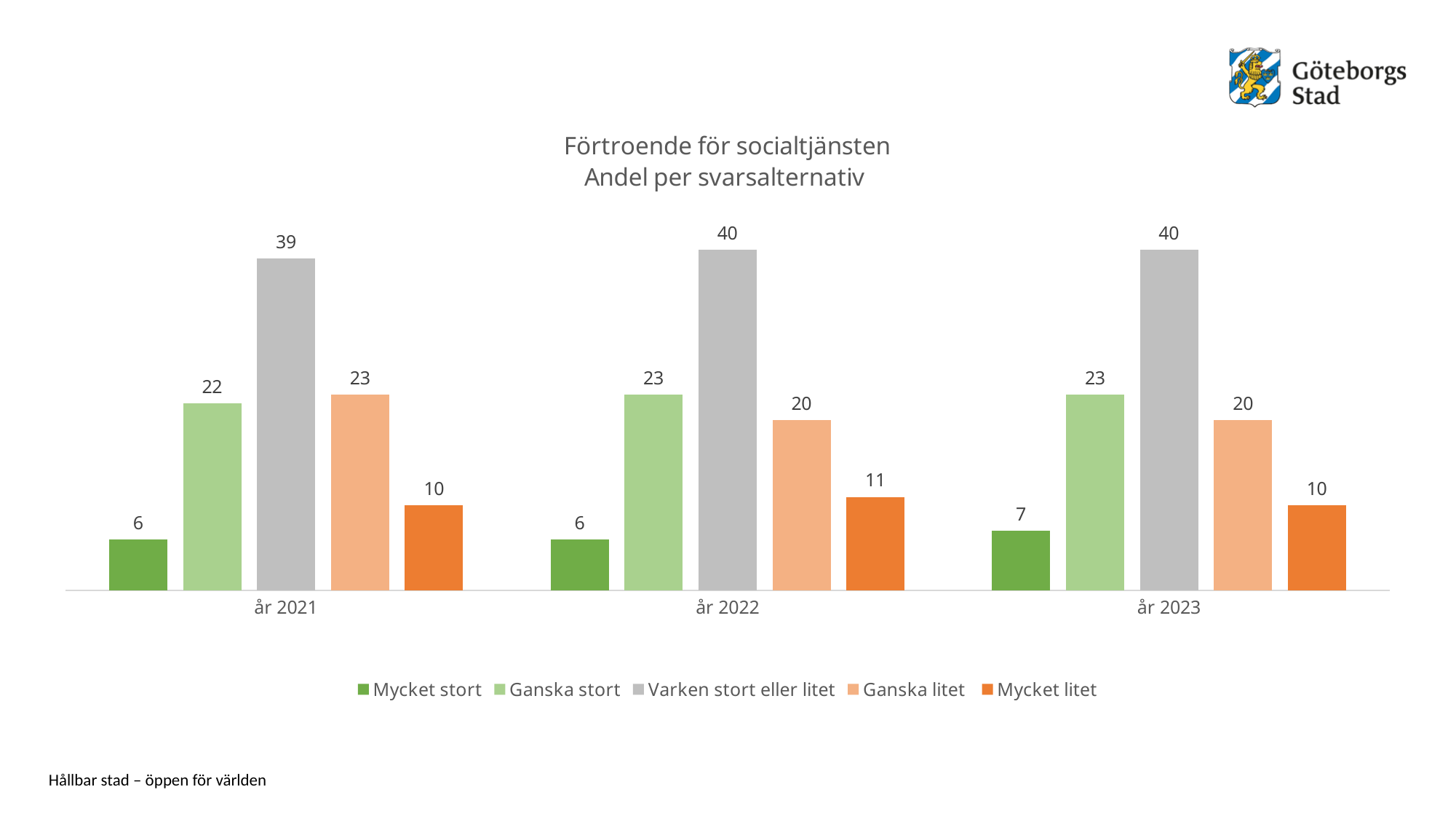
How many series does the legend list? 5 Does the value for Ganska litet rise or fall from år 2021 to år 2023? Fall What kind of chart is shown on the slide? Bar chart What is the value for Mycket stort in år 2023? 7 Which response alternative has the lowest value in år 2021? Mycket stort What is the title of the chart? Förtroende för socialtjänsten Andel per svarsalternativ How many year categories are shown on the x axis? 3 Which response alternative has the highest value in år 2022? Varken stort eller litet What is the value for Ganska litet in år 2022? 20 What is the value for Varken stort eller litet in år 2021? 39 Which is larger in år 2021: Ganska stort or Ganska litet? Ganska litet What is the difference between Ganska stort and Mycket litet in år 2023? 13